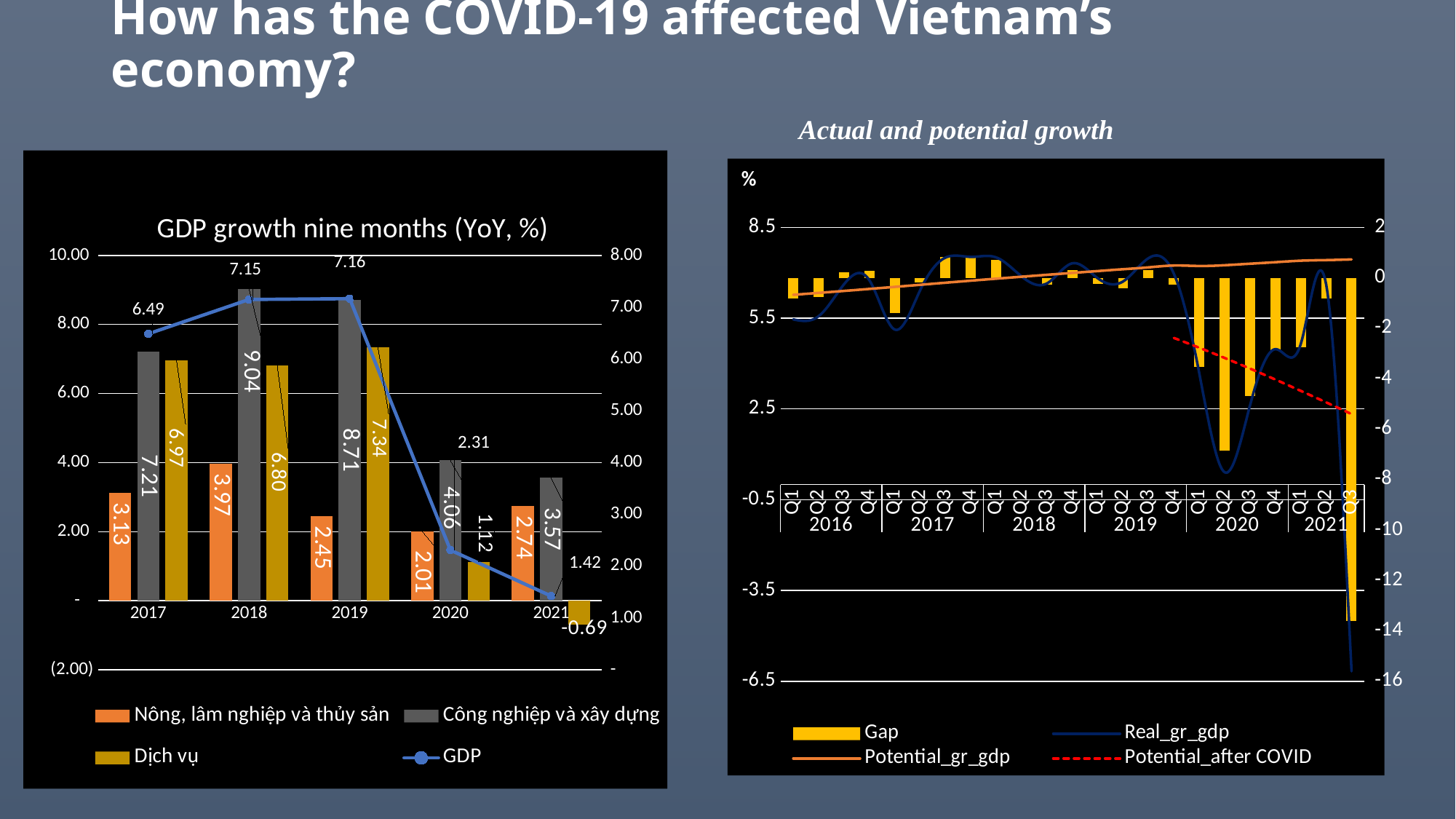
In the 'GDP growth nine months (YoY, %)' chart, what is the GDP value for 2018? 7.15 In the 'GDP growth nine months (YoY, %)' chart, how many years are shown on the x axis? 5 In the 'GDP growth nine months (YoY, %)' chart, what is the value for Nông, lâm nghiệp và thủy sản in 2019? 2.45 In the 'GDP growth nine months (YoY, %)' chart, in which year is Công nghiệp và xây dựng highest? 2018 In the 'GDP growth nine months (YoY, %)' chart, what is the value for Dịch vụ in 2021? -0.69 In the 'Actual and potential growth' chart, does the Potential_gr_gdp line rise or fall from 2016 to 2021? Rises In the 'Actual and potential growth' chart, how many series does the legend list? 4 In the 'GDP growth nine months (YoY, %)' chart, in which year is the GDP line lowest? 2021 In the 'GDP growth nine months (YoY, %)' chart, how many series does the legend list? 4 In the 'GDP growth nine months (YoY, %)' chart, what is the difference between the GDP values for 2019 and 2020? 4.85 What kind of chart is the 'GDP growth nine months (YoY, %)' chart? Combined bar and line chart In the 'GDP growth nine months (YoY, %)' chart, which is larger in 2017: Công nghiệp và xây dựng or Dịch vụ? Công nghiệp và xây dựng